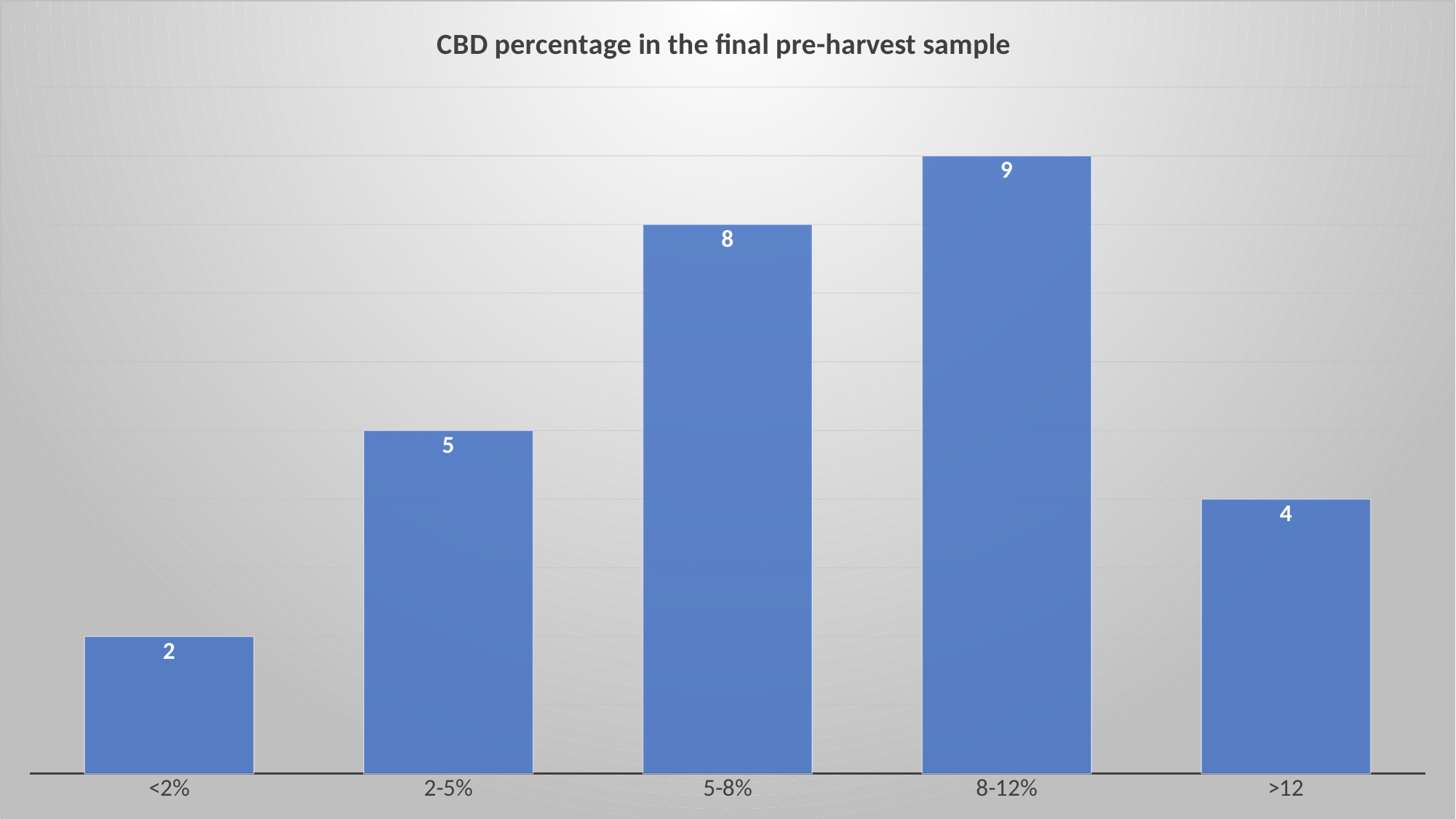
What is the value for the >12 category? 4 What is the value for the 5-8% category? 8 Which category has the highest value? 8-12% What is the value for the <2% category? 2 What is the difference between the values for 8-12% and 2-5%? 4 What is the value for the 2-5% category? 5 Which category has the lowest value? <2% What kind of chart is shown on the slide? Bar chart What is the total of the values for <2% and >12? 6 Which is larger, the value for 5-8% or the value for >12? 5-8% How many categories are shown on the x axis? 5 What is the title of the chart? CBD percentage in the final pre-harvest sample